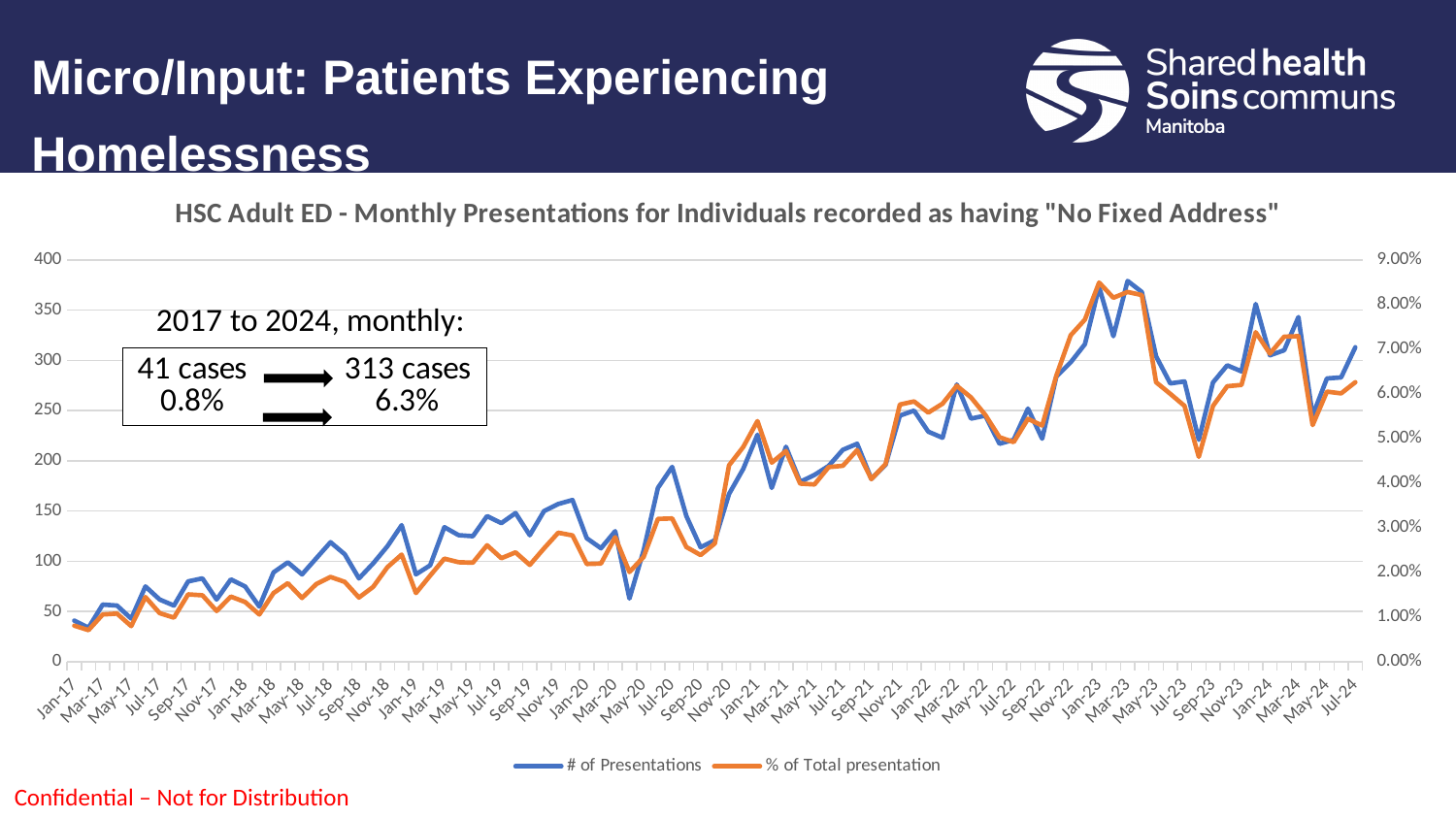
Is the # of Presentations value for Mar-23 greater or less than 350? greater What are the two series named in the chart legend? # of Presentations and % of Total presentation How many series does the chart legend list? 2 According to the annotation, what was the percentage of total presentations at the start of the period in 2017? 0.8% According to the annotation, how many cases were there at the start of the period in 2017? 41 cases By how many cases did the monthly count increase from the 2017 value to the 2024 value shown in the annotation? 272 cases What is the title of the chart? HSC Adult ED - Monthly Presentations for Individuals recorded as having "No Fixed Address" According to the annotation, how many cases were there at the end of the period in 2024? 313 cases According to the annotation, what was the percentage of total presentations at the end of the period in 2024? 6.3% Overall, do the # of Presentations values rise or fall from Jan-17 to Jul-24? rise What kind of chart is shown on the slide? line chart